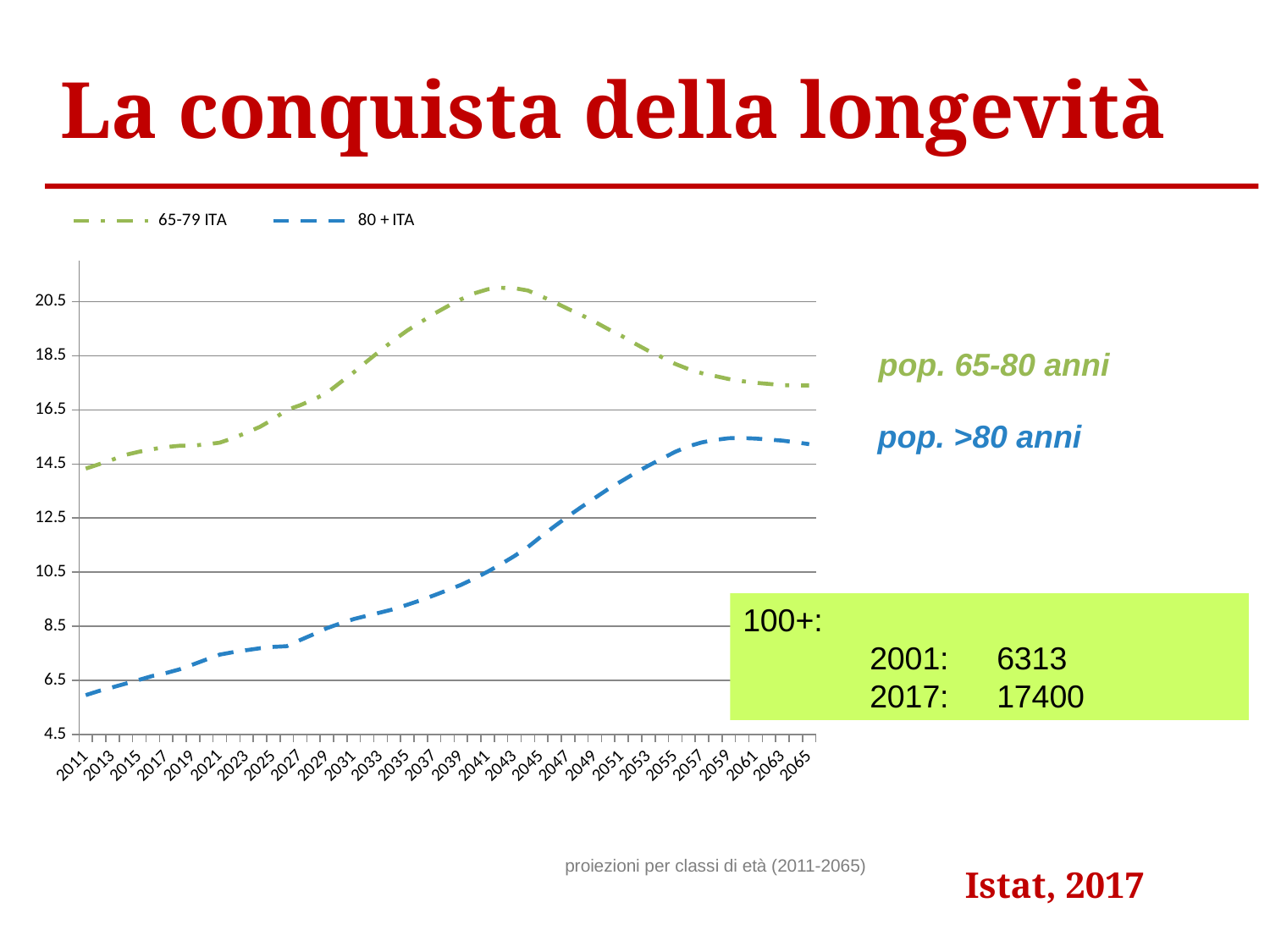
What kind of chart is shown on the slide? line chart In which year is the 80 + ITA series at its lowest? 2011 Is the value for 65-79 ITA in 2011 greater or less than 16.5? less What colour is the line for the 80 + ITA series? blue Does the 80 + ITA series generally rise or fall from 2011 to 2065? rise How many series does the chart legend list? 2 Is the value for 80 + ITA in 2065 greater or less than 12.5? greater Is the value for 80 + ITA in 2011 greater or less than 8.5? less How many years are labelled on the x axis of the chart? 28 In 2011, which series has the larger value, 65-79 ITA or 80 + ITA? 65-79 ITA What are the two series named in the chart legend? 65-79 ITA and 80 + ITA